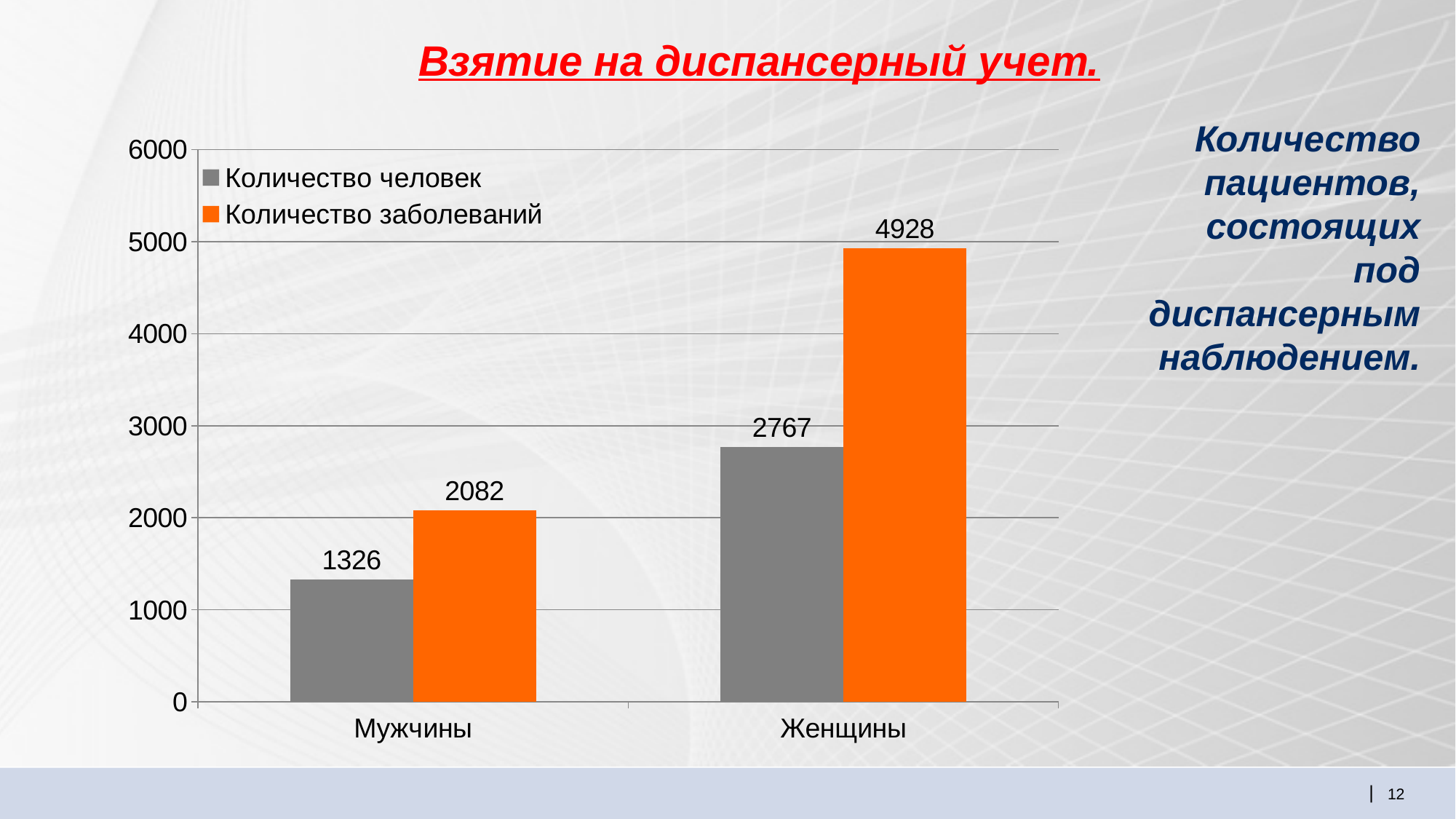
Which category has the highest value for "Количество заболеваний"? Женщины Which category has the lowest value for "Количество человек"? Мужчины Which is larger: "Количество заболеваний" for Мужчины or "Количество человек" for Женщины? Количество человек for Женщины What is the value of "Количество заболеваний" for Женщины? 4928 What is the value of "Количество заболеваний" for Мужчины? 2082 How many series does the legend list? 2 What is the difference between "Количество заболеваний" and "Количество человек" for Женщины? 2161 How many categories are shown on the x axis? 2 What is the value of "Количество человек" for Мужчины? 1326 What kind of chart is shown on the slide? Bar chart What is the value of "Количество человек" for Женщины? 2767 What is the difference in "Количество человек" between Женщины and Мужчины? 1441